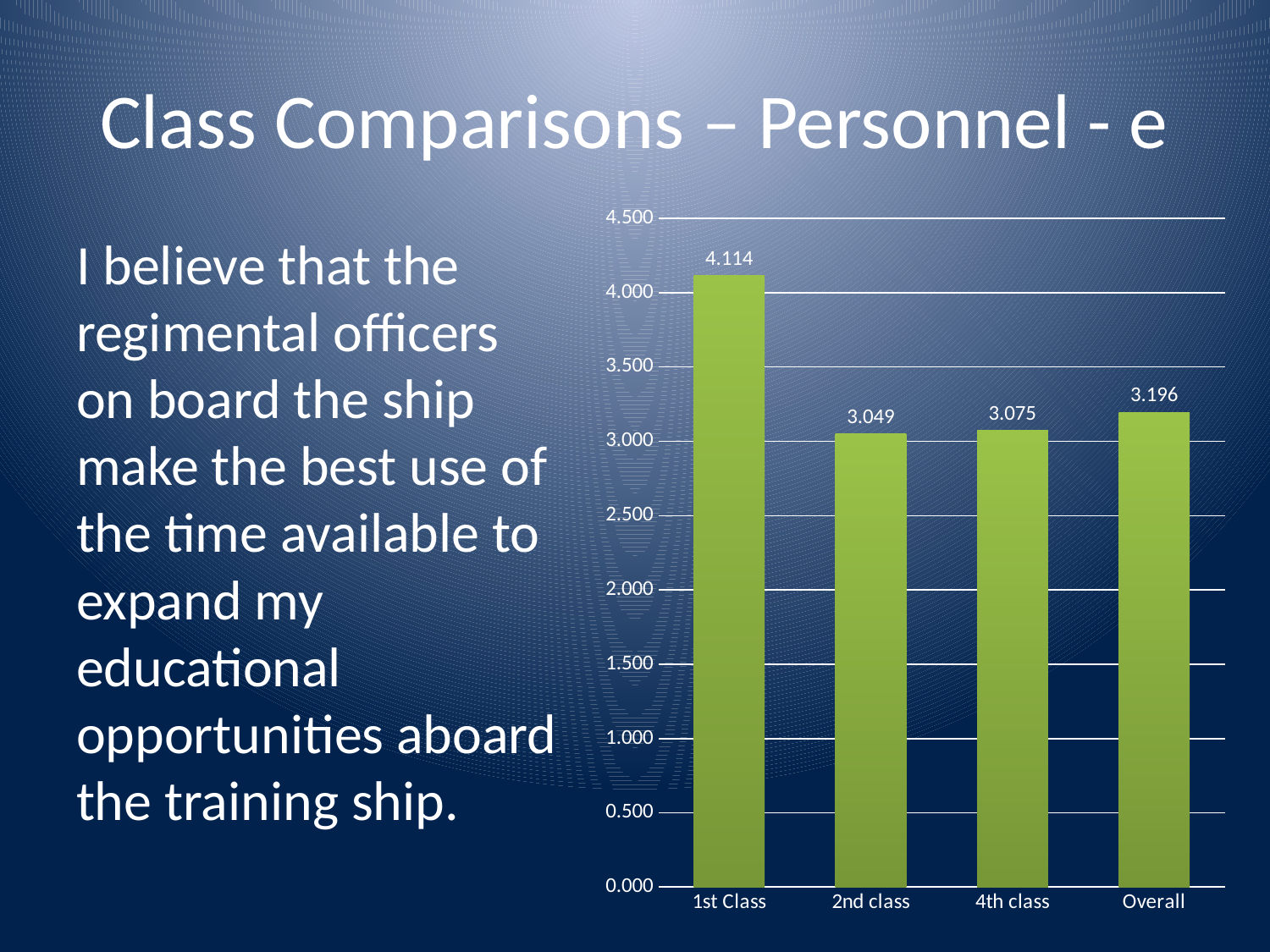
Is the value for 1st Class greater or less than 4.000? greater Which category has the highest value? 1st Class What kind of chart is shown on the slide? bar chart Which category has the lowest value? 2nd class What is the value for 2nd class? 3.049 Which is larger, the value for 1st Class or the value for 4th class? 1st Class What is the difference between the values for 4th class and 2nd class? 0.026 What is the value for 4th class? 3.075 How many categories are shown on the x axis? 4 What is the value for 1st Class? 4.114 What is the difference between the values for 1st Class and Overall? 0.918 What is the value for Overall? 3.196